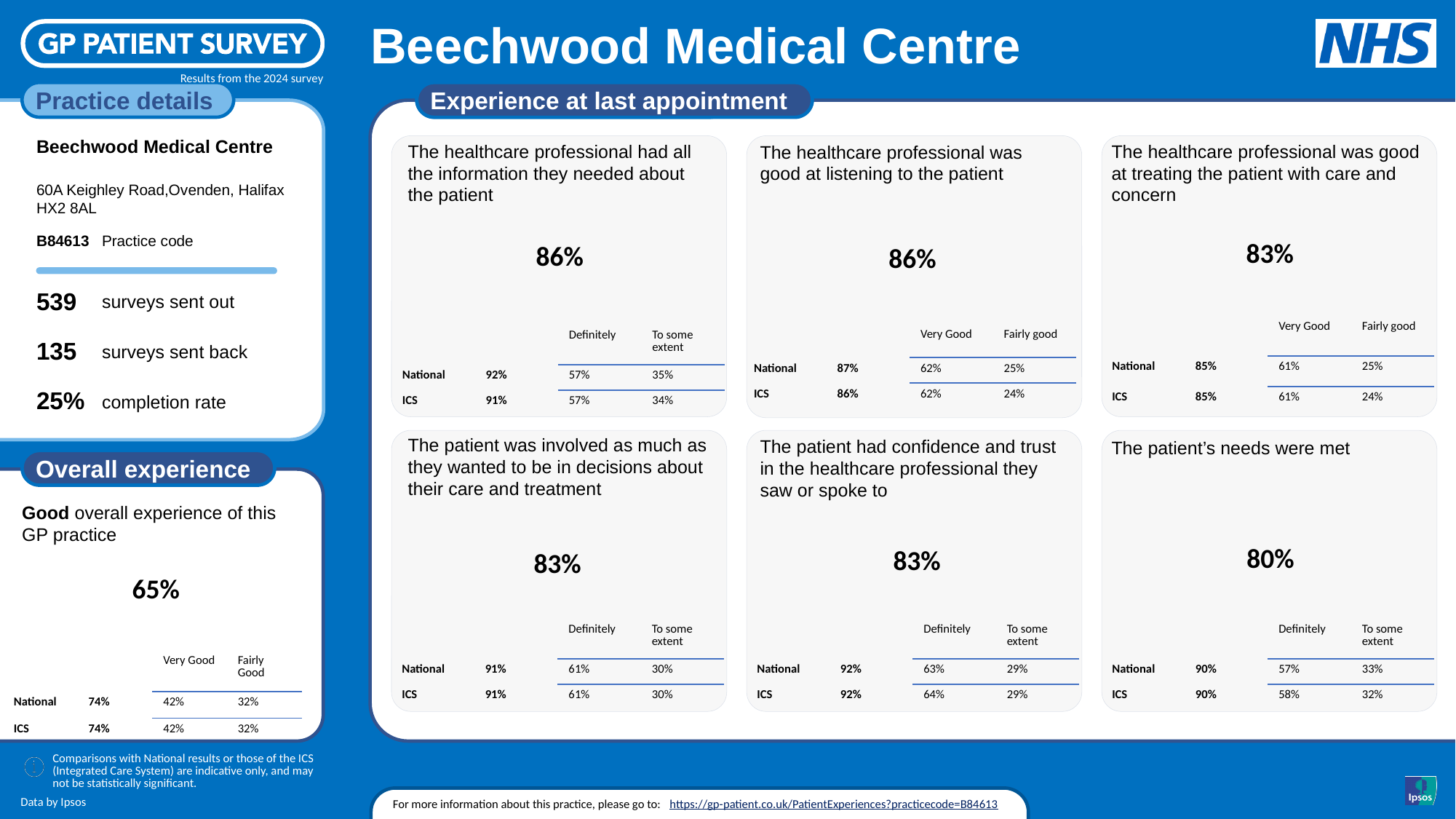
On the 'Good overall experience of this GP practice' chart, what is the National value? 74% On the 'The healthcare professional was good at listening to the patient' chart, which is larger, the practice's value or the National value? National On the 'The patient was involved as much as they wanted to be in decisions about their care and treatment' chart, what is the practice's value? 83% On the 'The healthcare professional had all the information they needed about the patient' chart, what is the ICS value? 91% On the 'Good overall experience of this GP practice' chart, what is the practice's value? 65% How many charts are shown under the 'Experience at last appointment' heading? 6 Across the six 'Experience at last appointment' charts, which question has the lowest practice value? The patient's needs were met On the 'The patient's needs were met' chart, what is the difference between the National value and the practice's value? 10% On the 'The healthcare professional had all the information they needed about the patient' chart, what is the practice's value? 86% On the 'The patient had confidence and trust in the healthcare professional they saw or spoke to' chart, what is the ICS 'Definitely' value? 64% On the 'The healthcare professional was good at treating the patient with care and concern' chart, what is the National 'Very Good' value? 61% On the 'Good overall experience of this GP practice' chart, what is the difference between the National value and the practice's value? 9%